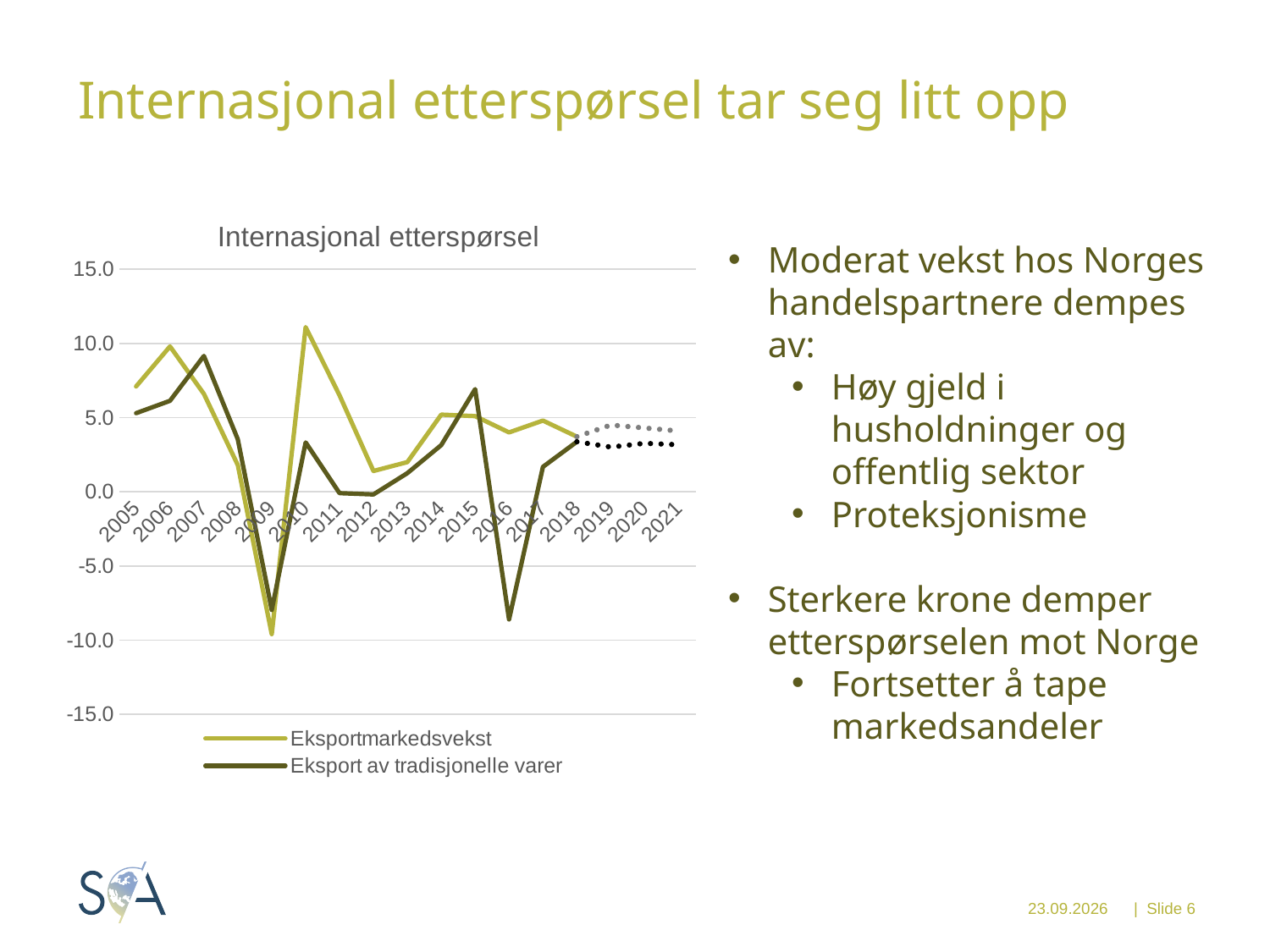
What kind of chart is shown on the slide? Line chart How many series does the legend of the chart list? 2 How many years are shown on the x axis of the chart? 17 Is the value for Eksport av tradisjonelle varer in 2016 greater or less than -5.0? less Which series is drawn with the darker line in the chart? Eksport av tradisjonelle varer In which year is Eksportmarkedsvekst at its highest? 2010 What is the title of the chart? Internasjonal etterspørsel In 2010, which series has the higher value: Eksportmarkedsvekst or Eksport av tradisjonelle varer? Eksportmarkedsvekst Does Eksportmarkedsvekst rise or fall from 2010 to 2012? Fall In which year is Eksportmarkedsvekst at its lowest? 2009 Is the value for Eksportmarkedsvekst in 2010 greater or less than 10.0? greater In which year is Eksport av tradisjonelle varer at its highest? 2007